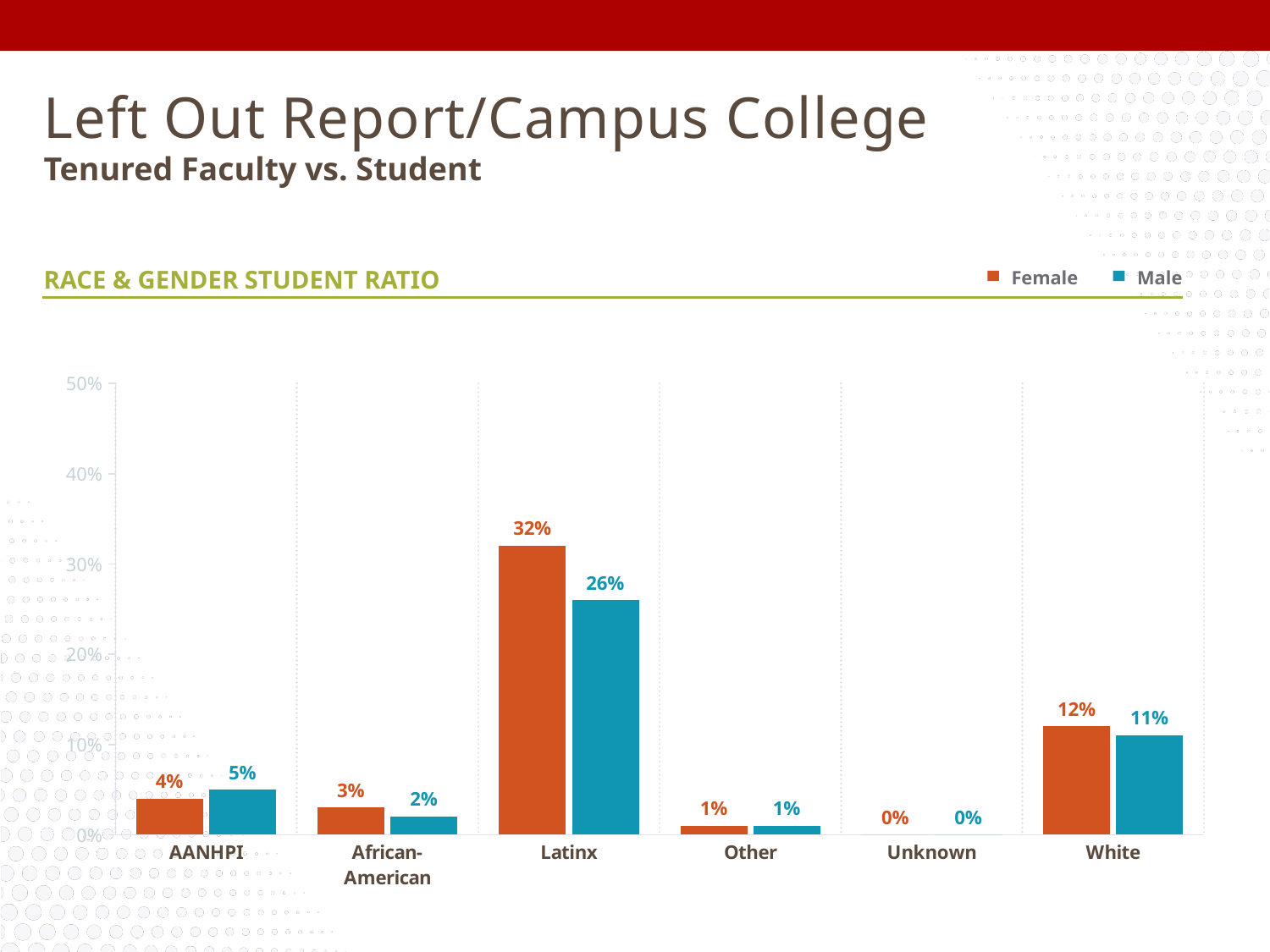
How many categories are shown on the x axis? 6 Which category has the lowest Male value? Unknown What is the difference between the Female and Male values for Latinx? 6% Which is larger for African-American, the Female value or the Male value? Female How many series does the legend list? 2 What is the Male value for White? 11% What is the Male value for AANHPI? 5% What is the title of the chart? RACE & GENDER STUDENT RATIO What is the Female value for Latinx? 32% Which category has the highest Female value? Latinx What kind of chart is shown on the slide? Bar chart Is the Female value for Latinx greater or less than 30%? greater